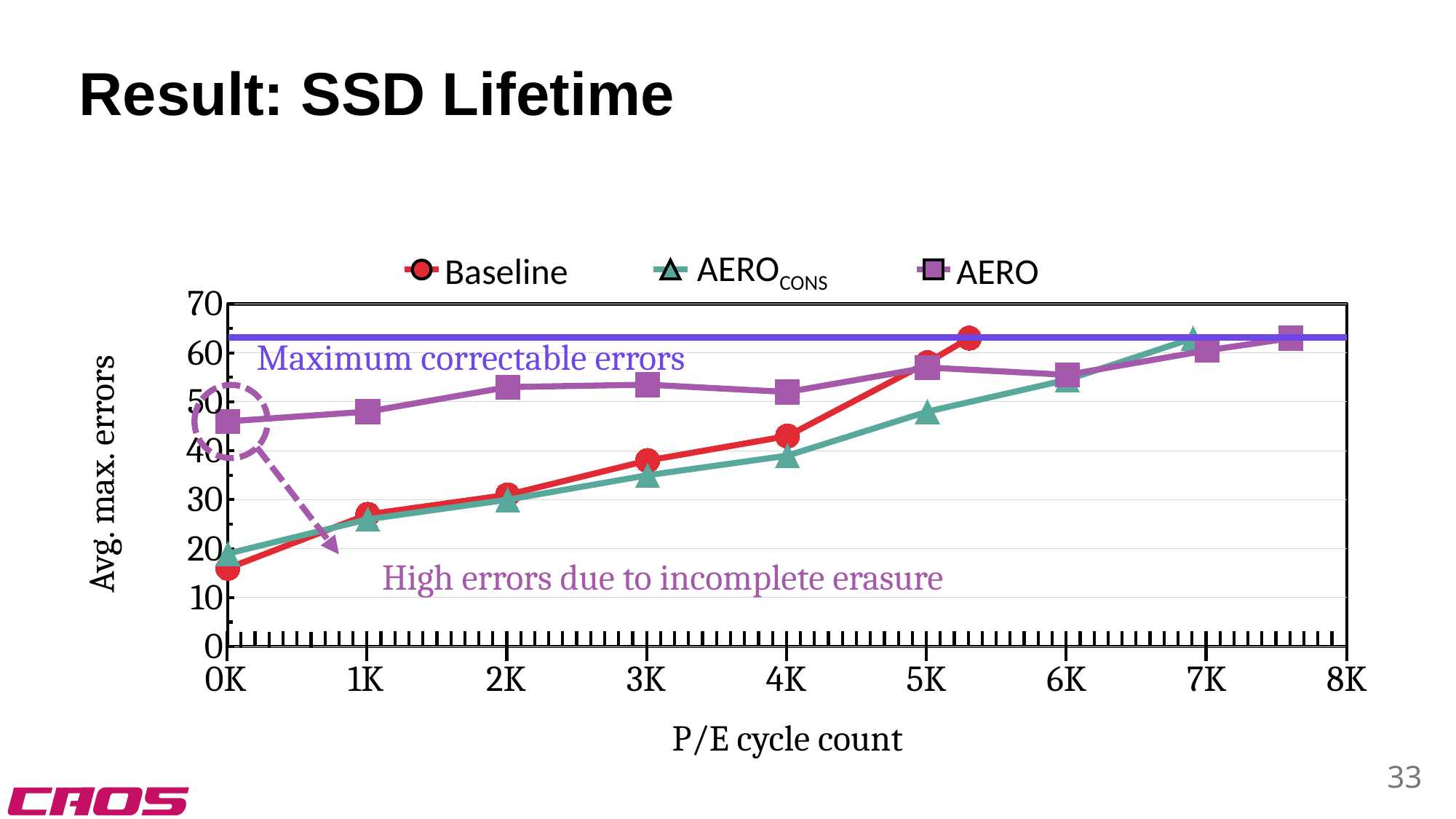
Do the Baseline values rise or fall as the P/E cycle count increases? rise What is the label of the x axis? P/E cycle count Is the value for Baseline at 5K P/E cycles greater or less than 50? greater At 1K P/E cycles, which is larger: AERO or AERO_CONS? AERO Is the value for AERO at 2K P/E cycles greater or less than 50? greater How many series does the legend list? 3 What does the horizontal line near the top of the chart represent? Maximum correctable errors At 5K P/E cycles, which is larger: Baseline or AERO_CONS? Baseline What kind of chart is shown on the slide? line chart Is the value for Baseline at 0K P/E cycles greater or less than 20? less Which series has the highest Avg. max. errors at 0K P/E cycles? AERO